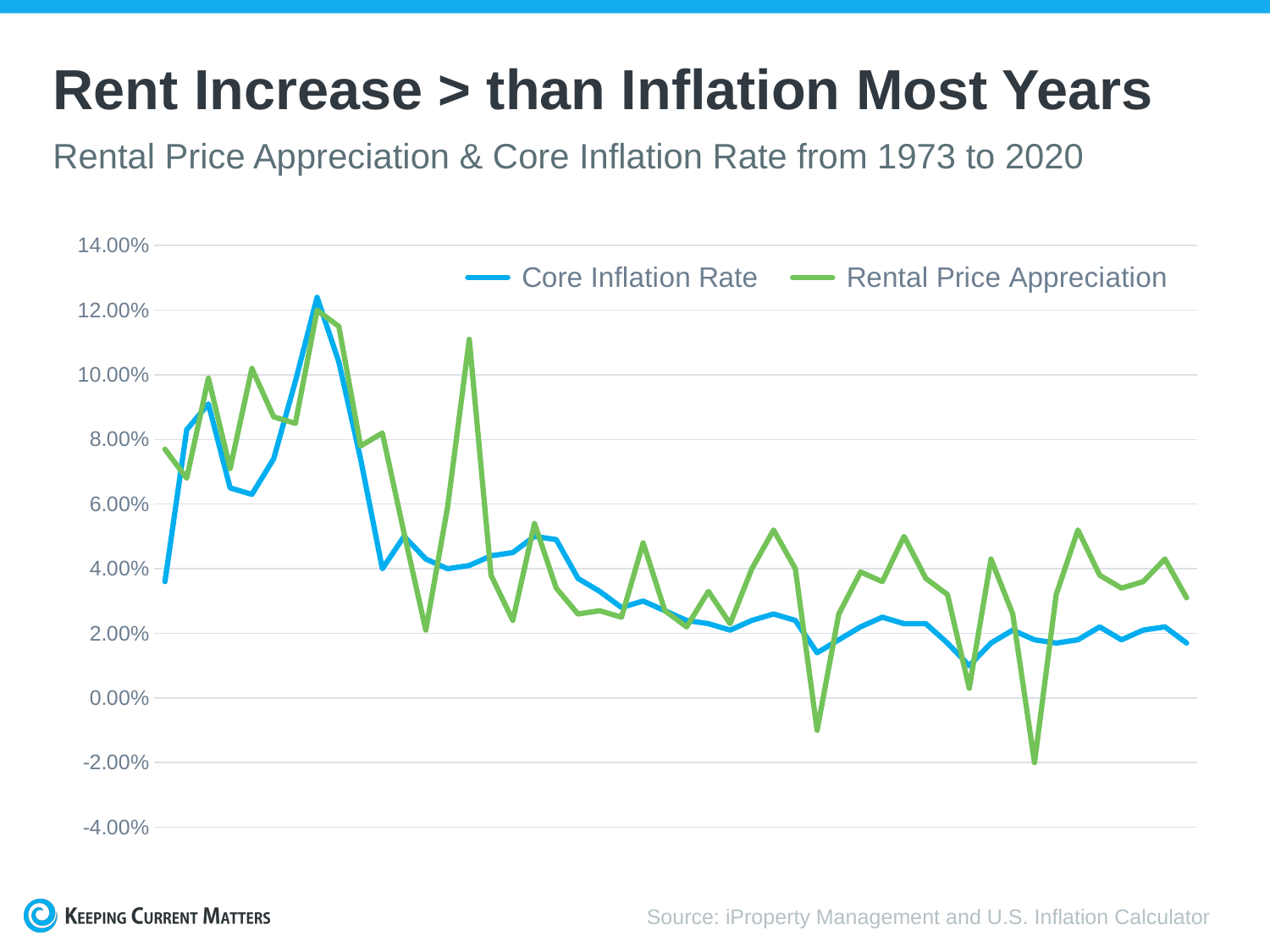
Is the final value of the Rental Price Appreciation line greater or less than 2.00%? greater What are the two series named in the legend? Core Inflation Rate and Rental Price Appreciation What kind of chart is shown on the slide? line chart Do the values of the Core Inflation Rate line generally rise or fall from left to right across the chart? fall Is the highest value of the Rental Price Appreciation line greater or less than 10.00%? greater Which colour is used for the Rental Price Appreciation line? green Is the lowest value of the Rental Price Appreciation line greater or less than 0.00%? less Which series reaches the lowest point on the chart? Rental Price Appreciation How many series does the legend list? 2